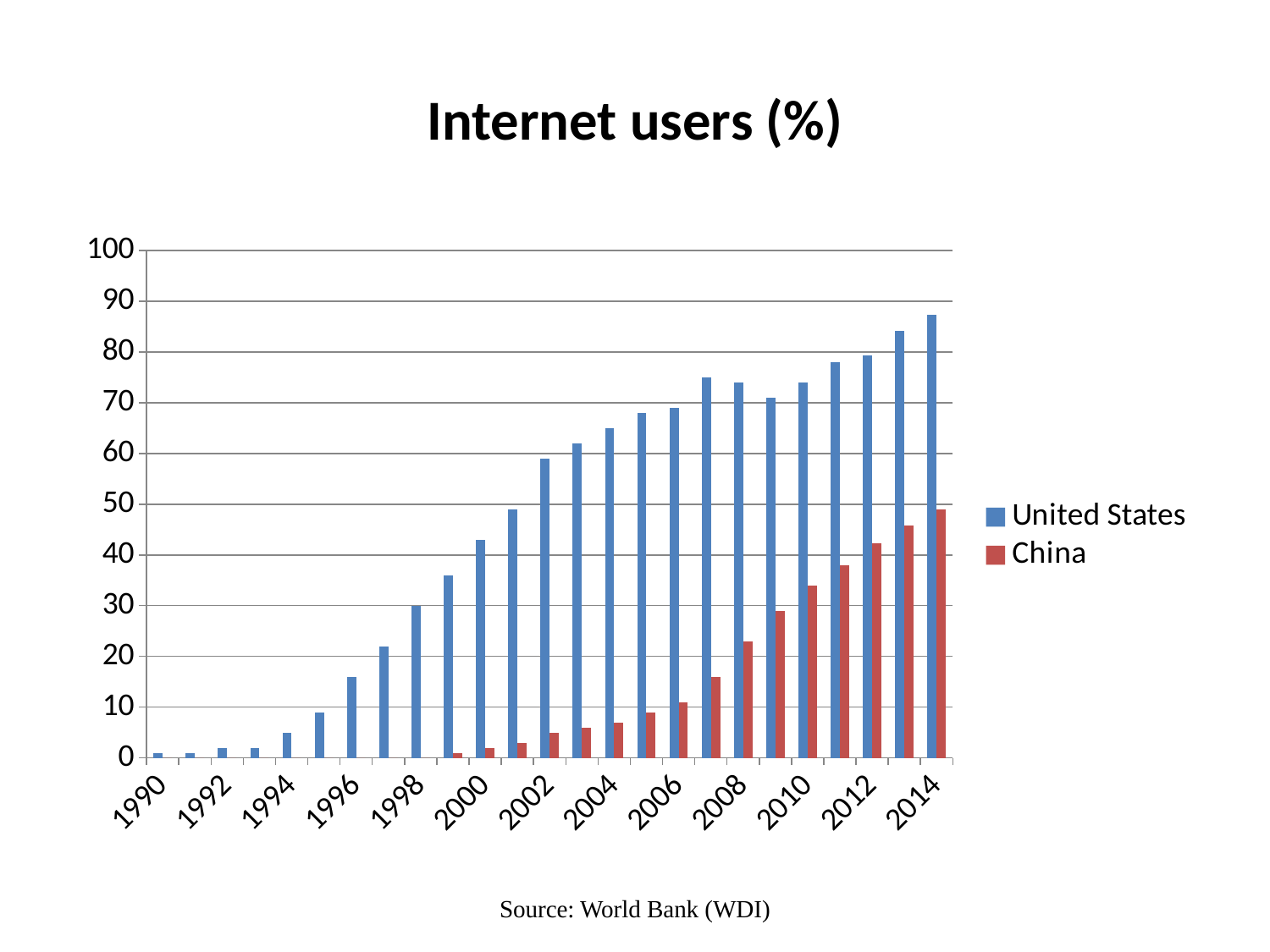
Is the value for China in 2014 greater or less than 40? greater Is the value for China in 2010 greater or less than 30? greater Do the values for China rise or fall from 2000 to 2014? rise Is the value for the United States in 2014 greater or less than 80? greater Which year has the highest value for China? 2014 Which two series are shown in the legend? United States and China How many series does the legend list? 2 What kind of chart is shown on the slide? bar chart Which year has the highest value for the United States? 2014 What is the title of the chart? Internet users (%) In 2014, which series has the larger value, United States or China? United States